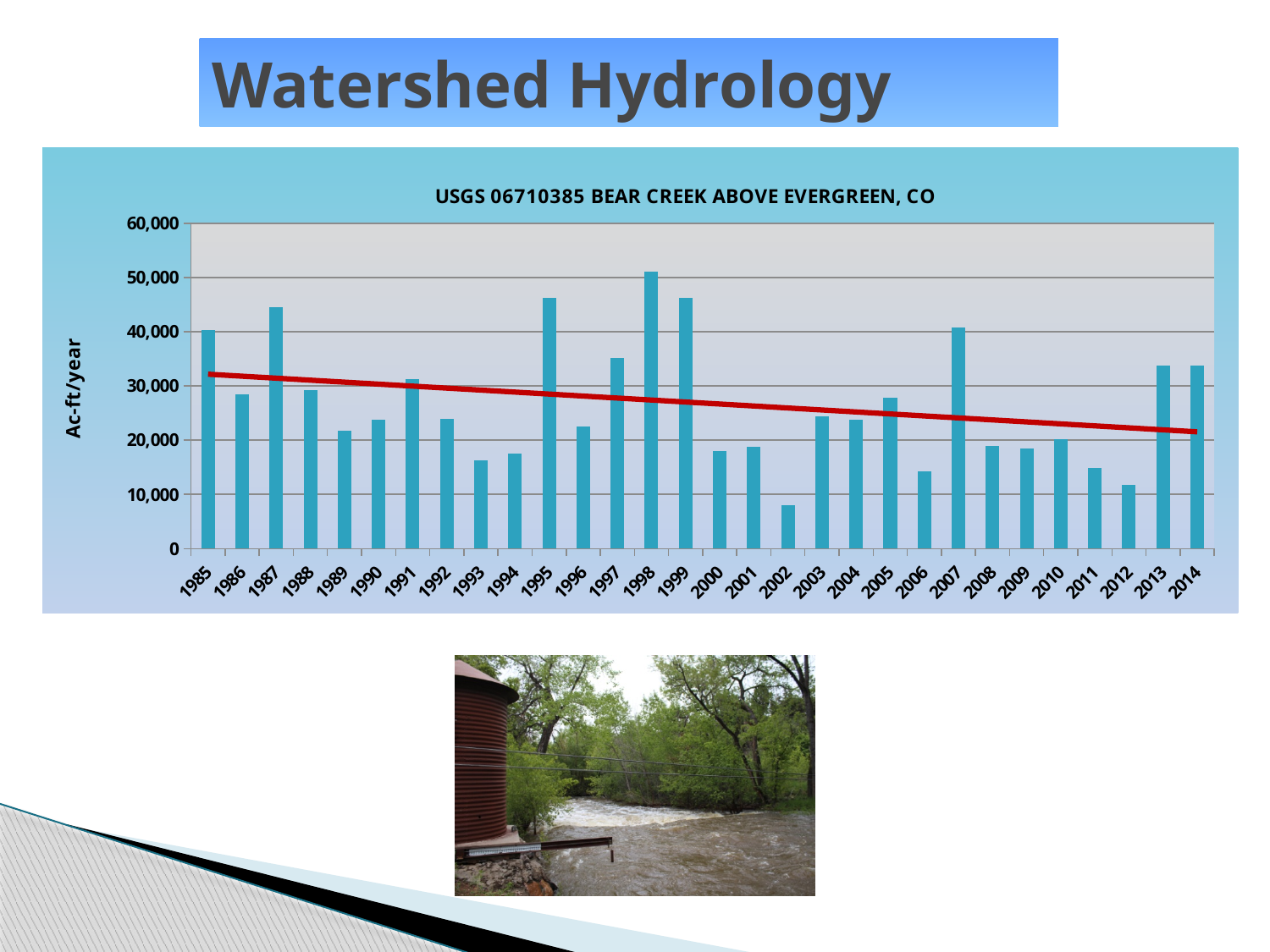
Is the value for 1987 greater or less than 40,000? greater Is the value for 2002 greater or less than 10,000? less What kind of chart is shown on the slide? bar chart Which year has the larger value, 1995 or 1996? 1995 Which year has the lowest bar in the chart? 2002 How many years are plotted as bars in the chart? 30 Is the value for 2006 greater or less than 20,000? less What is the title of the chart? USGS 06710385 BEAR CREEK ABOVE EVERGREEN, CO What is the label on the vertical axis of the chart? Ac-ft/year Does the red trend line rise or fall from 1985 to 2014? fall Which year has the highest bar in the chart? 1998